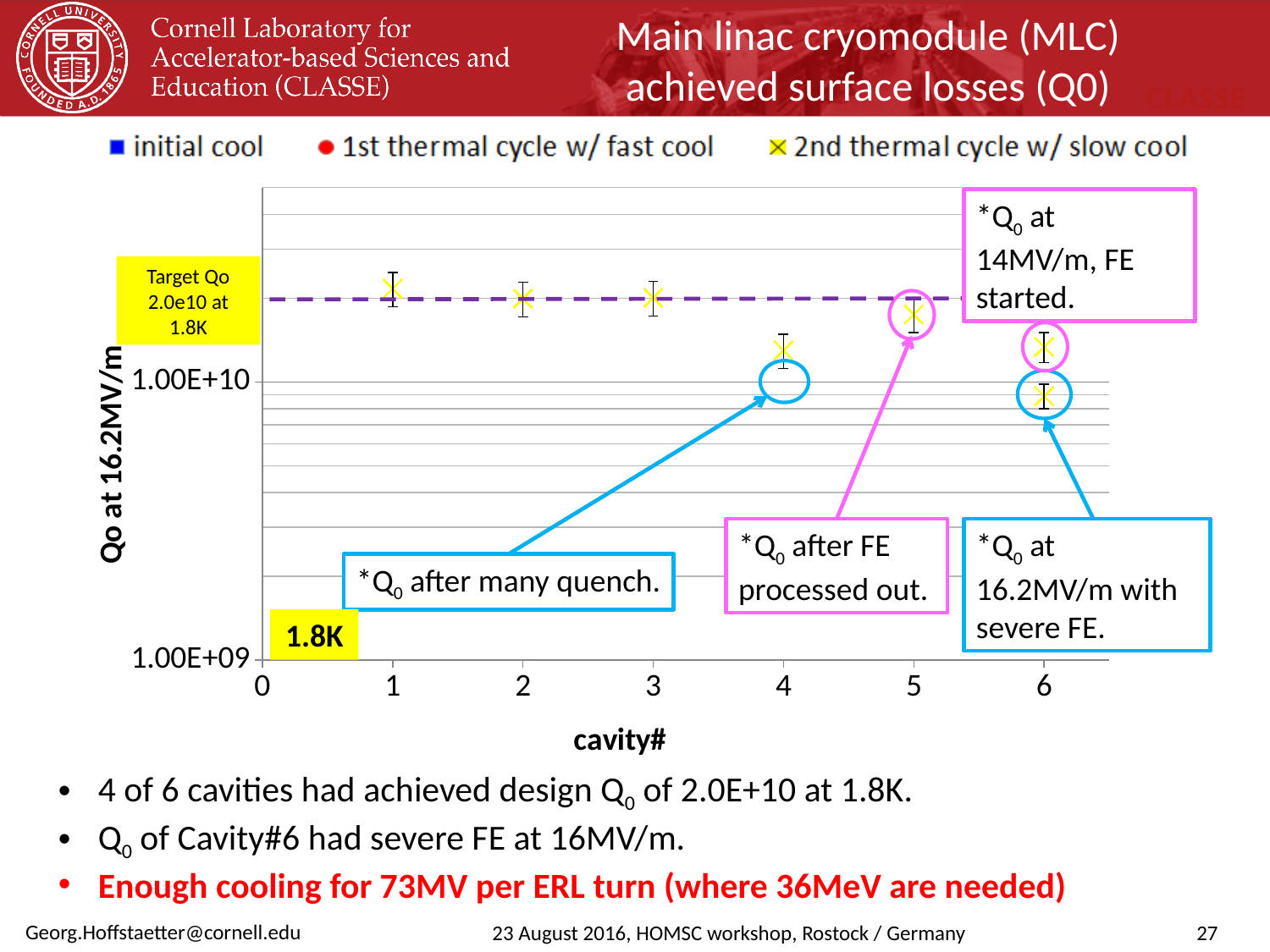
Which has the larger plotted Qo value, cavity 3 or cavity 6? cavity 3 What is the title of the y axis of the chart? Qo at 16.2MV/m What kind of chart is shown on the slide? scatter chart Is the lower of the two points plotted for cavity 6 greater or less than 1.00E+10? less Is the value for cavity 1 greater or less than 1.00E+10? greater Is the value for cavity 3 greater or less than 1.00E+10? greater How many series does the chart legend list? 3 Which has the larger plotted Qo value, cavity 1 or cavity 4? cavity 1 What target Qo value does the dashed line on the chart represent? 2.0e10 at 1.8K How many cavities are labelled along the x axis of the chart (excluding 0)? 6 Which cavity has the lowest plotted Qo value on the chart? 6